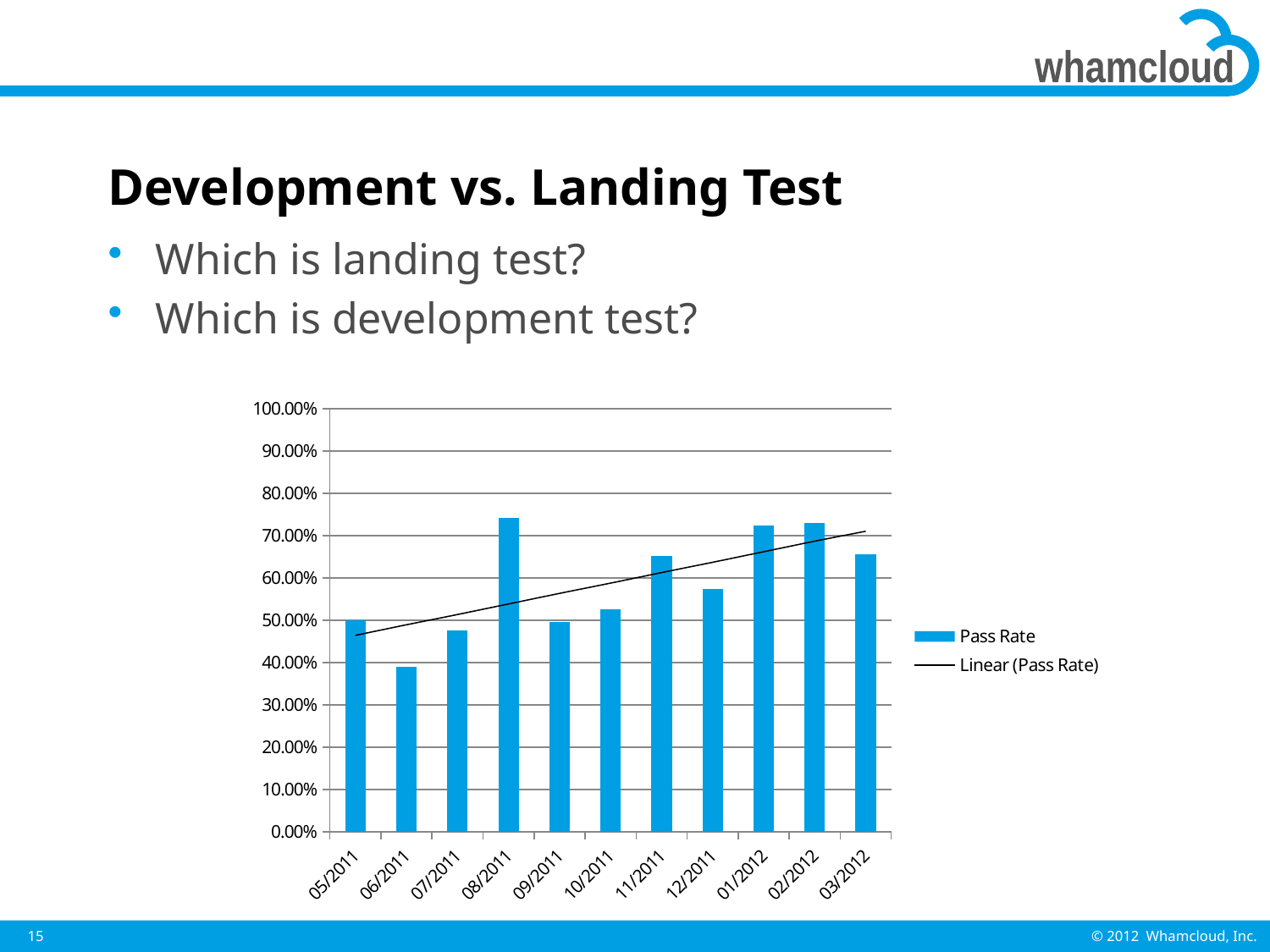
Is the pass rate for 07/2011 greater or less than 50.00%? less Which month has the lowest pass rate? 06/2011 What is the name of the series plotted as bars in the chart? Pass Rate What kind of chart is shown on the slide? bar chart Does the linear trend line for Pass Rate rise or fall from 05/2011 to 03/2012? rise Is the pass rate for 12/2011 greater or less than 60.00%? less Which has the higher pass rate, 11/2011 or 12/2011? 11/2011 Is the pass rate for 08/2011 greater or less than 70.00%? greater How many entries does the chart's legend list? 2 How many months are shown on the x axis of the chart? 11 Which has the higher pass rate, 01/2012 or 03/2012? 01/2012